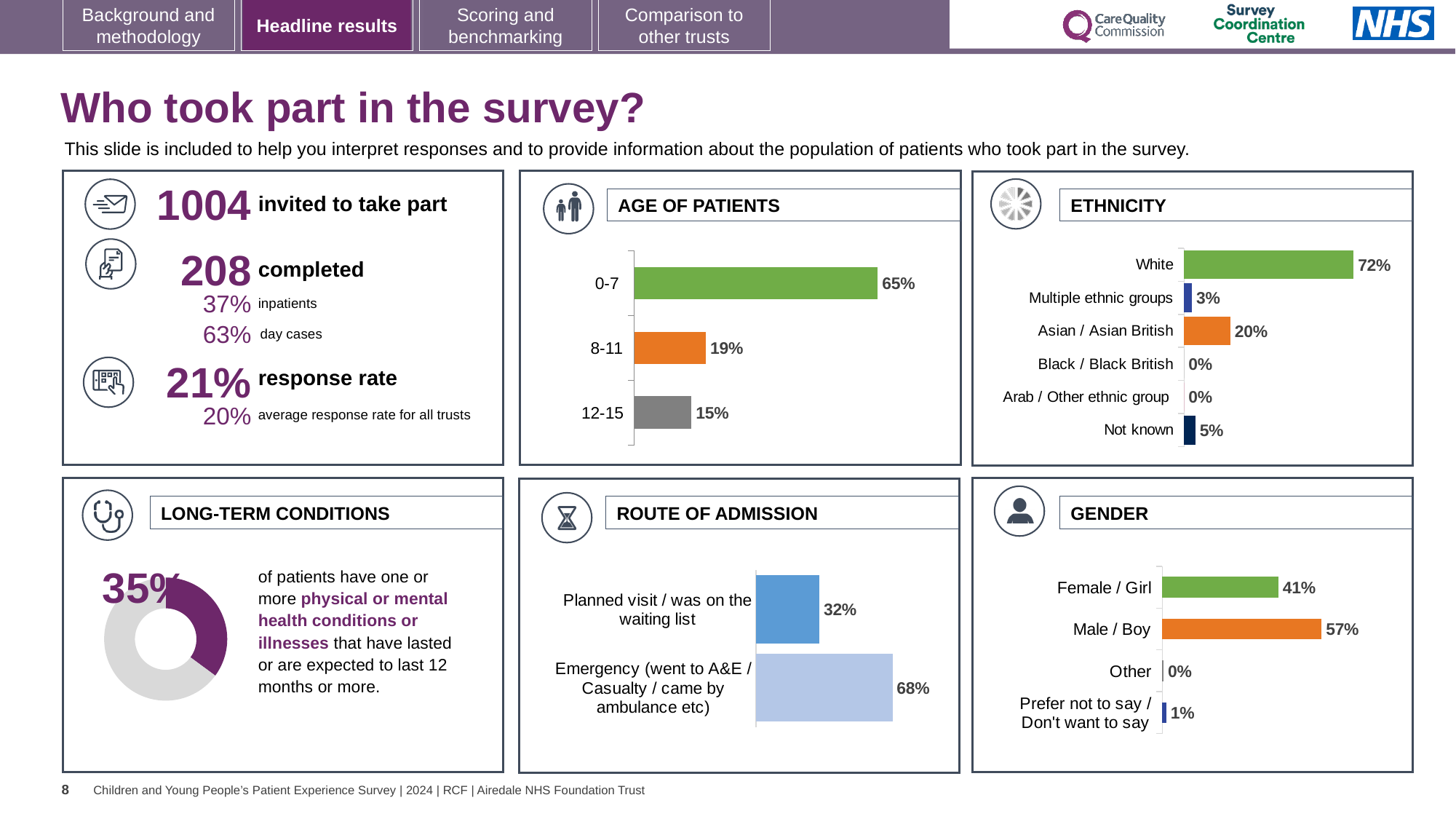
In the ETHNICITY chart, which category has the highest value? White In the AGE OF PATIENTS chart, what is the value for the 0-7 age group? 65% In the GENDER chart, what is the difference between Male / Boy and Female / Girl? 16% In the ETHNICITY chart, what is the value for Asian / Asian British? 20% In the LONG-TERM CONDITIONS chart, what share of patients have one or more long-term conditions? 35% In the ETHNICITY chart, which is larger: Not known or Multiple ethnic groups? Not known How many categories are shown in the ETHNICITY chart? 6 What kind of chart is the ROUTE OF ADMISSION chart? Bar chart In the AGE OF PATIENTS chart, what is the difference between the 0-7 and 8-11 values? 46% In the AGE OF PATIENTS chart, which age group has the lowest value? 12-15 In the ROUTE OF ADMISSION chart, what is the value for Emergency (went to A&E / Casualty / came by ambulance etc)? 68% In the GENDER chart, what is the value for Male / Boy? 57%